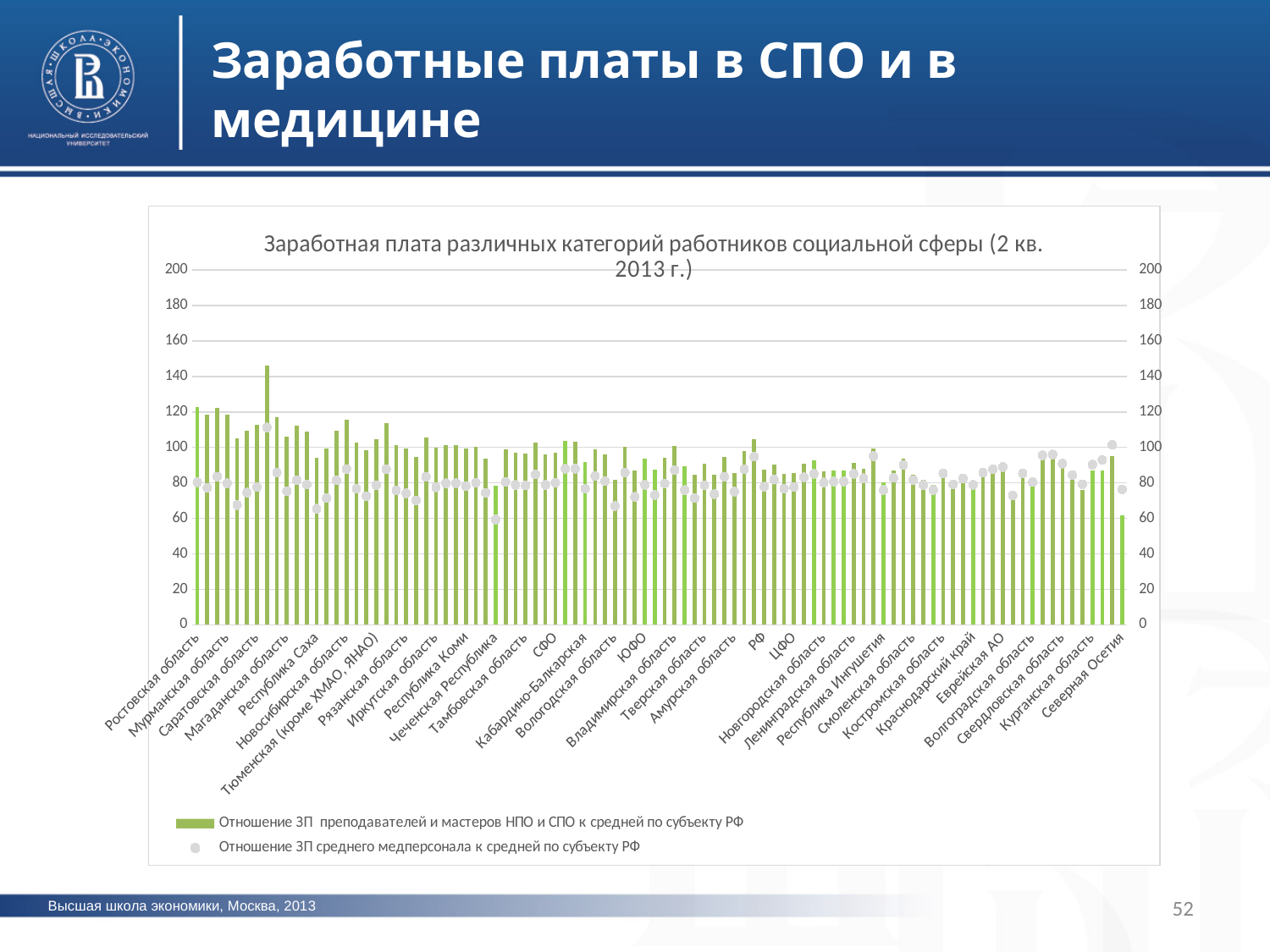
How many series does the legend list? 2 Which has the larger green bar value, Ростовская область or Северная Осетия? Ростовская область Do the green bar values generally rise or fall from left to right along the x axis? fall What is the maximum value shown on the vertical axis? 200 Is the green bar value for Ростовская область greater or less than 100? greater What kind of chart is shown on the slide? bar chart What is the title of the chart? Заработная плата различных категорий работников социальной сферы (2 кв. 2013 г.) Is the green bar value for Северная Осетия greater or less than 80? less Which series is shown with green bars according to the legend? Отношение ЗП преподавателей и мастеров НПО и СПО к средней по субъекту РФ